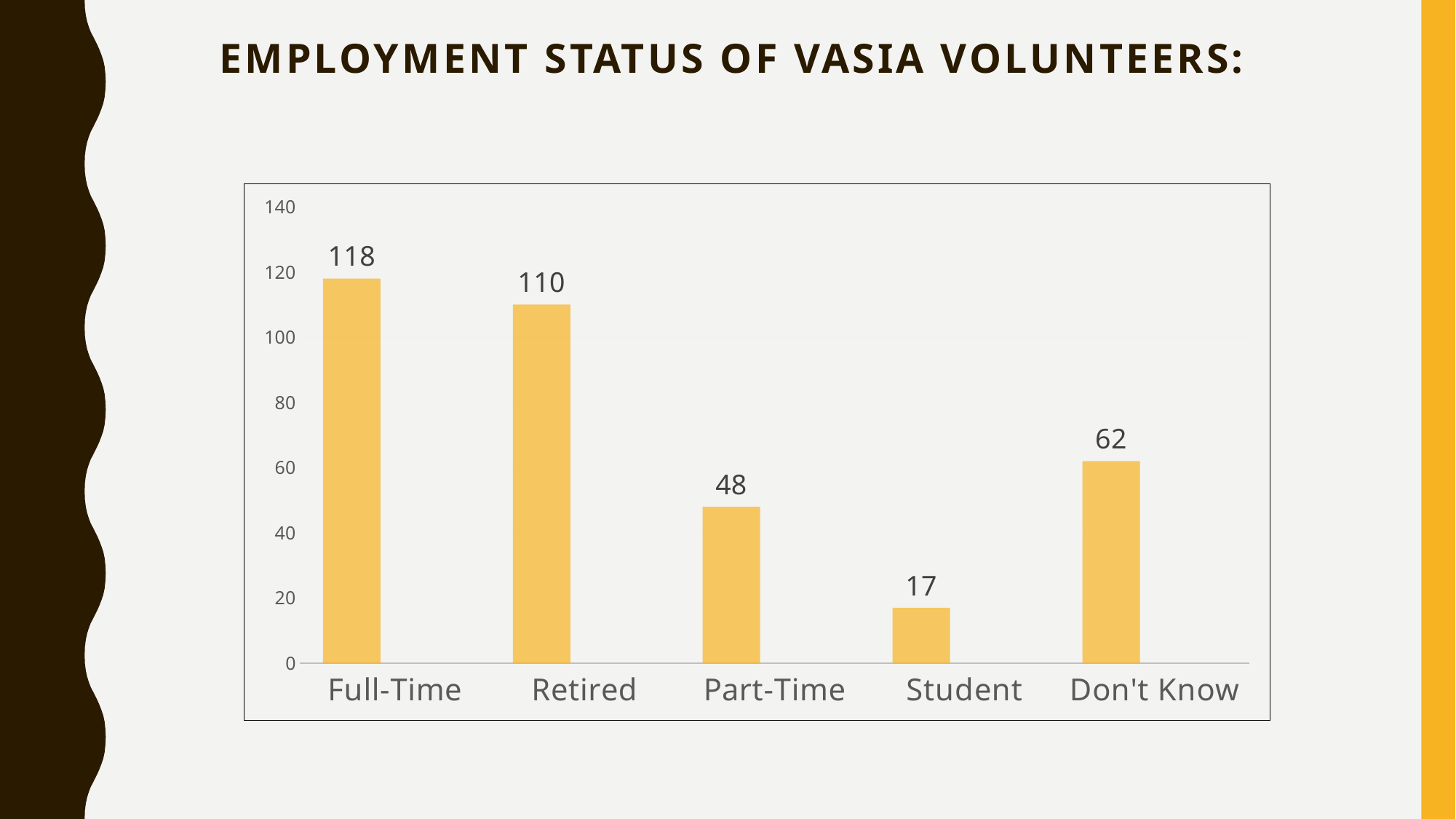
What is the value for Part-Time? 48 Is the value for Don't Know greater or less than 80? less What is the value for Retired? 110 Which category has the highest value? Full-Time What is the value for Full-Time? 118 How many categories are shown on the x axis? 5 Which category has the lowest value? Student What kind of chart is shown on the slide? bar chart Which is larger, the value for Part-Time or the value for Don't Know? Don't Know What is the value for Don't Know? 62 What is the value for Student? 17 What is the difference between the values for Full-Time and Retired? 8